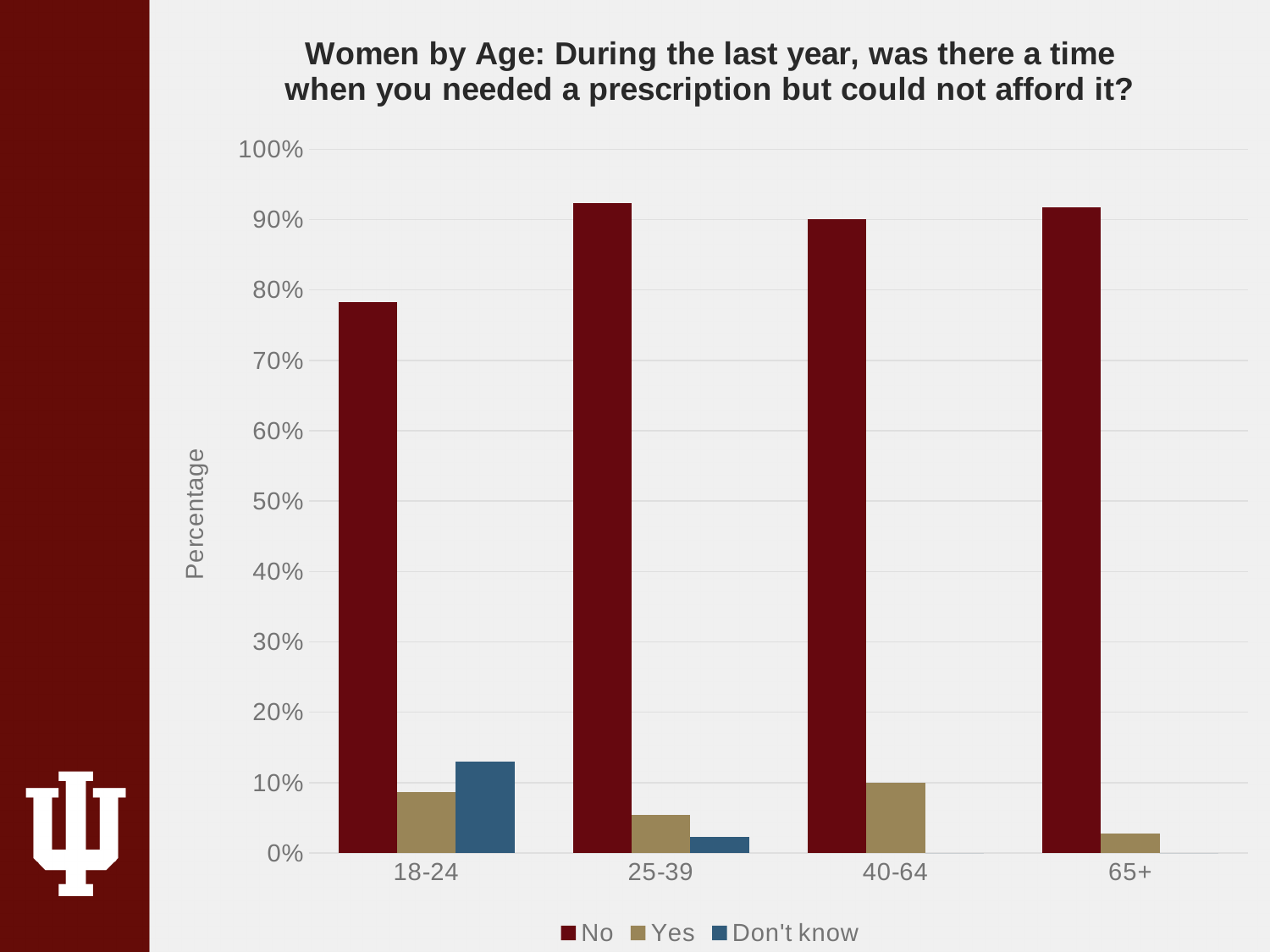
Is the "No" value for the 25-39 age group greater or less than 90%? greater What kind of chart is shown on the slide? Bar chart What is the label on the y axis? Percentage Is the "No" value for the 18-24 age group greater or less than 80%? less Is the "Yes" value for the 40-64 age group greater or less than 20%? less Which is larger for the 25-39 age group: the "Yes" value or the "Don't know" value? Yes Which age group has the highest value for the "Don't know" series? 18-24 How many series does the legend list? 3 How many age groups are shown on the x axis? 4 Which is larger for the 18-24 age group: the "Yes" value or the "Don't know" value? Don't know Which age group has the lowest value for the "No" series? 18-24